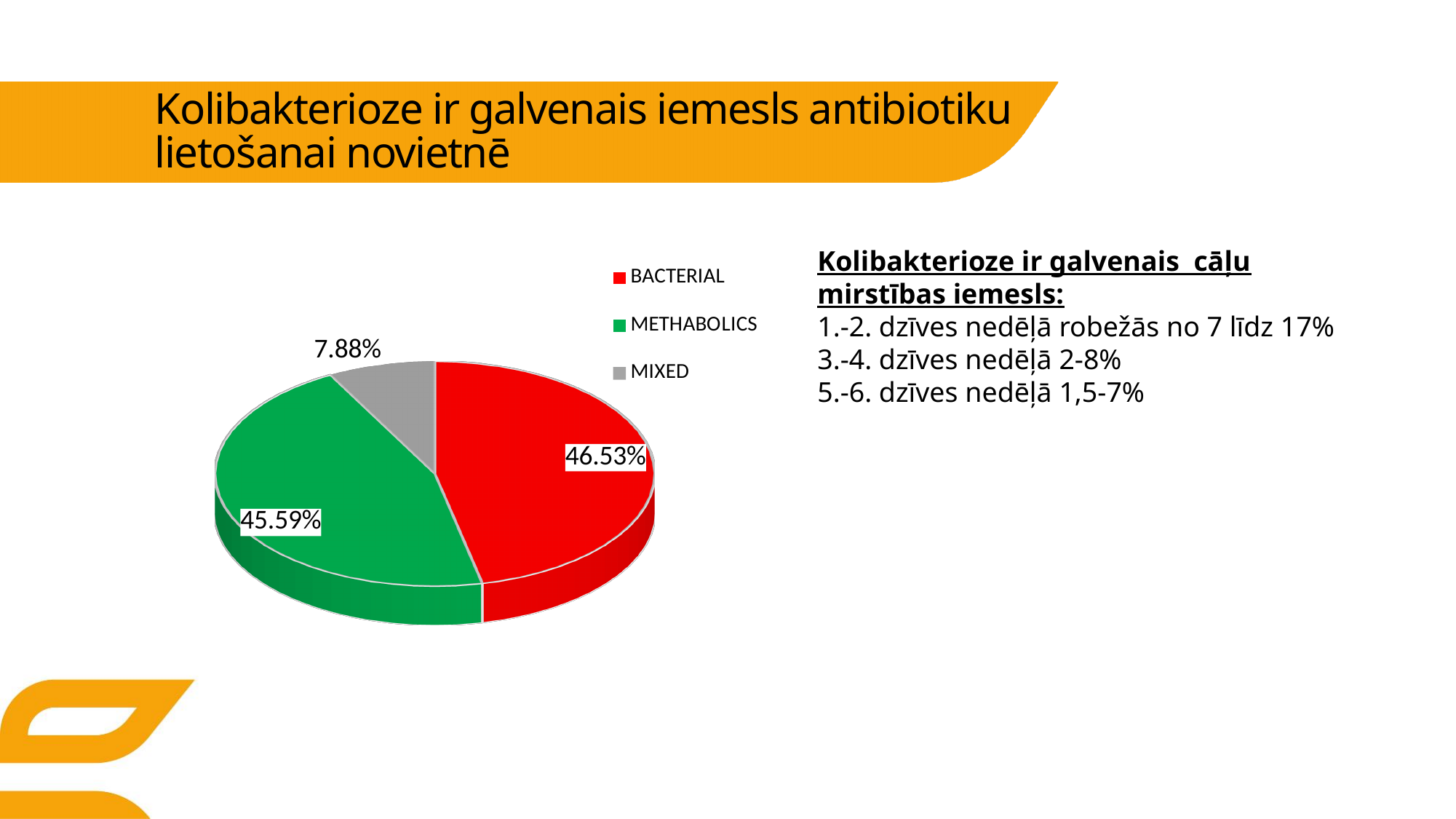
What percentage does the BACTERIAL slice of the pie chart show? 46.53% How many entries does the legend of the pie chart list? 3 What kind of chart is shown on the slide? pie chart What colour is the MIXED slice in the pie chart? grey What is the difference between the METHABOLICS and MIXED percentages in the pie chart? 37.71% What percentage does the MIXED slice of the pie chart show? 7.88% What percentage does the METHABOLICS slice of the pie chart show? 45.59% Which category has the largest slice in the pie chart? BACTERIAL What is the difference between the BACTERIAL and METHABOLICS percentages in the pie chart? 0.94% Which category has the smallest slice in the pie chart? MIXED How many slices does the pie chart have? 3 Which is larger in the pie chart, the METHABOLICS slice or the MIXED slice? METHABOLICS